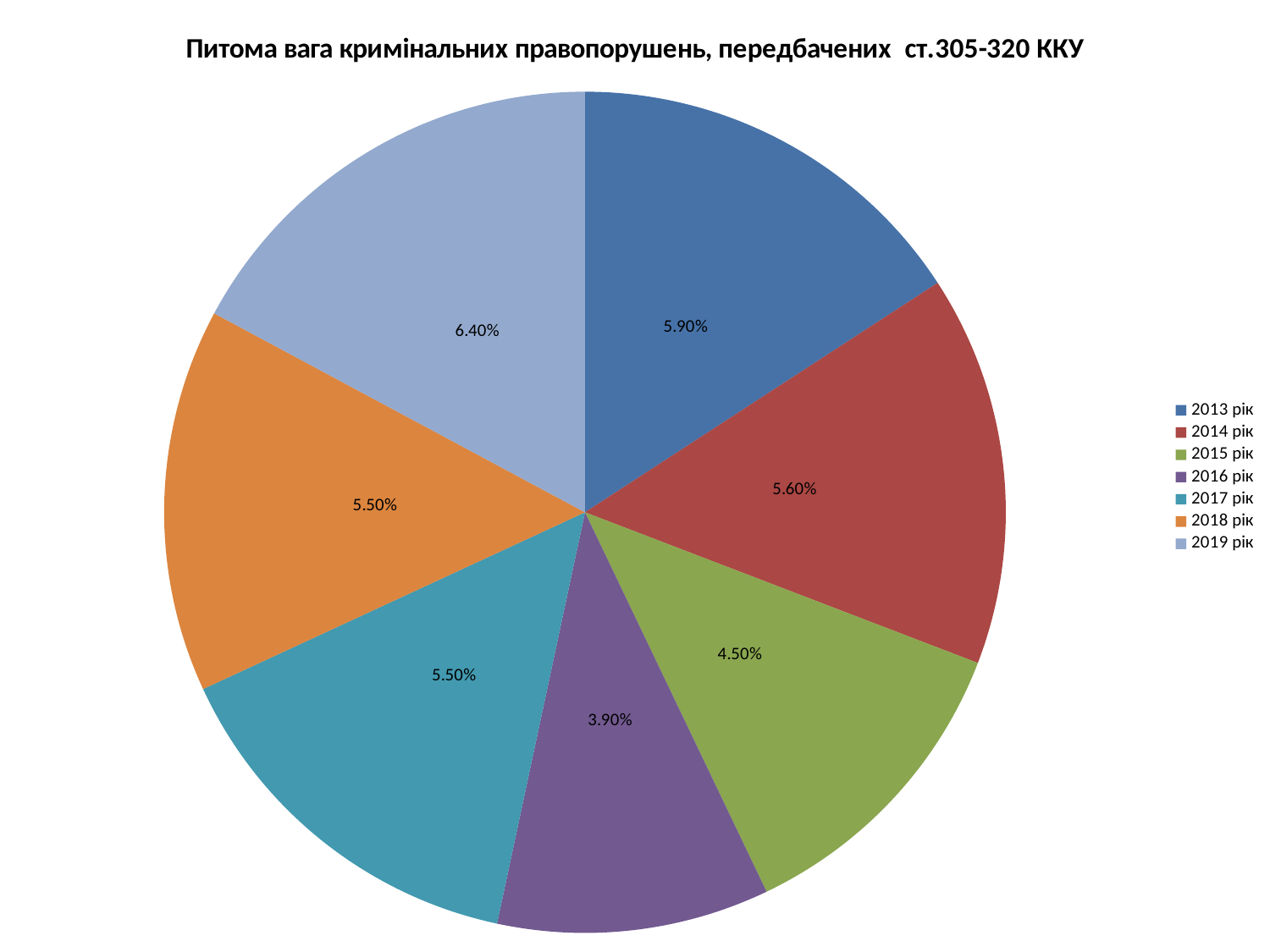
What kind of chart is shown on the slide? Pie chart Which is larger, the value for 2013 рік or 2014 рік? 2013 рік What value is shown for 2013 рік? 5.90% What value is shown for 2015 рік? 4.50% Which year has the smallest slice? 2016 рік What value is shown for 2019 рік? 6.40% What is the title of the chart? Питома вага кримінальних правопорушень, передбачених ст.305-320 ККУ How many slices does the pie chart have? 7 Which year has the largest slice? 2019 рік What is the difference between the values for 2013 рік and 2014 рік? 0.30% What is the difference between the values for 2019 рік and 2016 рік? 2.50% What value is shown for 2016 рік? 3.90%